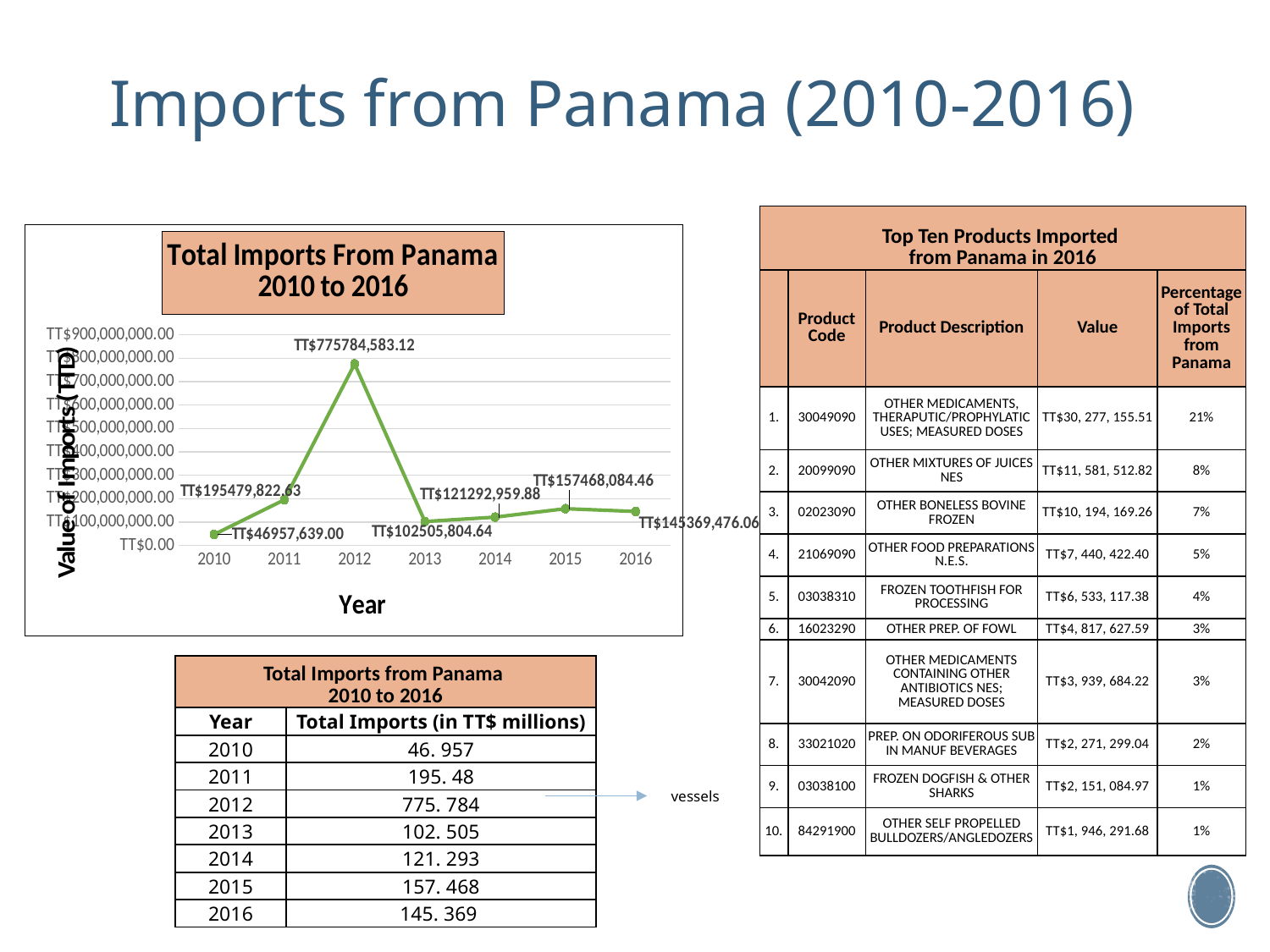
Which year has the lowest value on the 'Total Imports From Panama 2010 to 2016' chart? 2010 On the 'Total Imports From Panama 2010 to 2016' chart, do the values rise or fall from 2012 to 2013? fall On the 'Total Imports From Panama 2010 to 2016' chart, is the value for 2010 greater or less than TT$100,000,000.00? less How many years are plotted on the 'Total Imports From Panama 2010 to 2016' chart? 7 What is the data label for 2012 on the 'Total Imports From Panama 2010 to 2016' chart? TT$775784,583.12 On the 'Total Imports From Panama 2010 to 2016' chart, is the value for 2012 greater or less than TT$700,000,000.00? greater What is the label of the x axis on the 'Total Imports From Panama 2010 to 2016' chart? Year What is the data label for 2013 on the 'Total Imports From Panama 2010 to 2016' chart? TT$102505,804.64 What kind of chart is the 'Total Imports From Panama 2010 to 2016' chart? line chart What is the data label for 2015 on the 'Total Imports From Panama 2010 to 2016' chart? TT$157468,084.46 Which year has the highest value on the 'Total Imports From Panama 2010 to 2016' chart? 2012 On the 'Total Imports From Panama 2010 to 2016' chart, which year has the larger value, 2011 or 2014? 2011